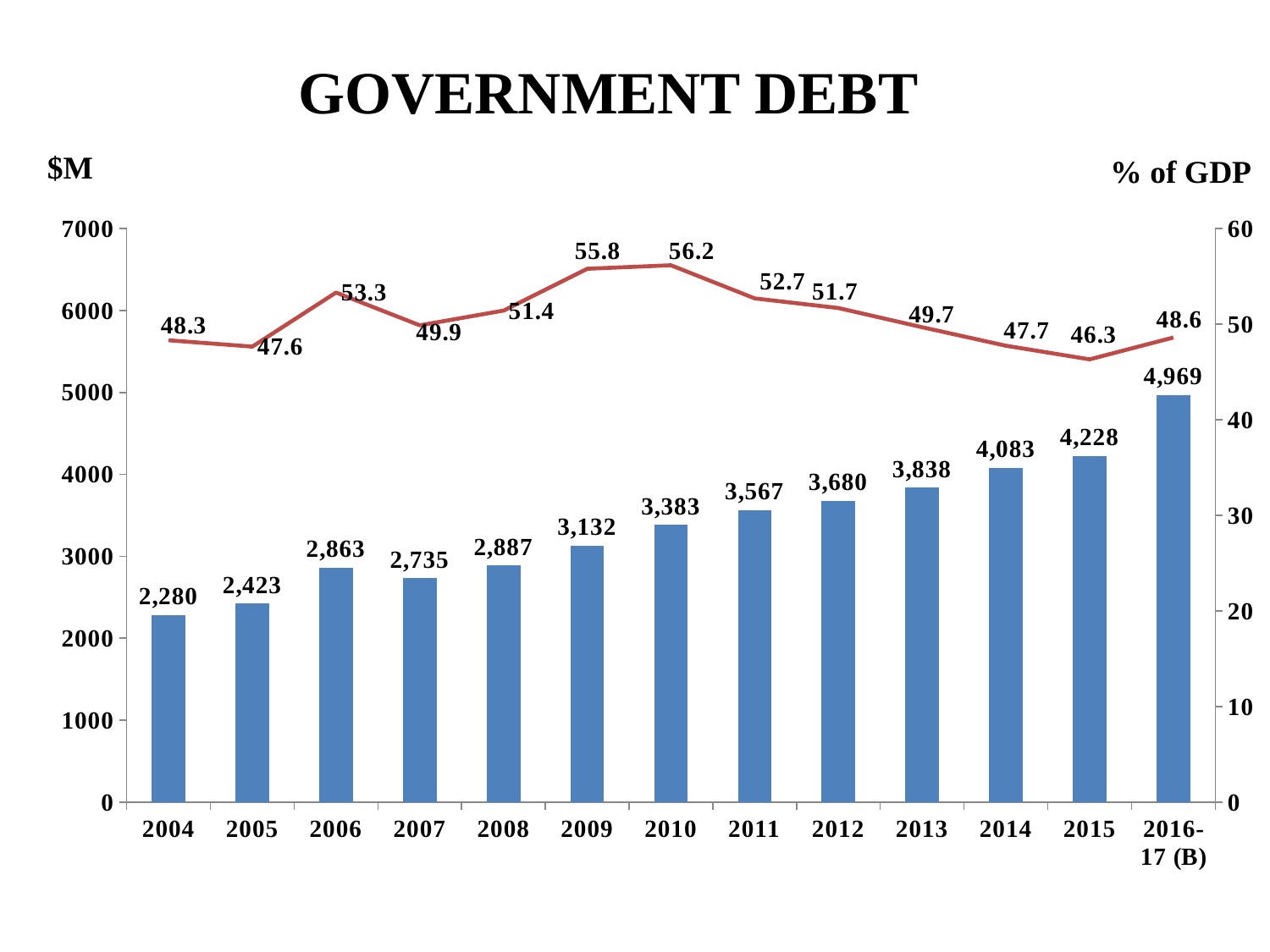
What is the difference in government debt ($M) between 2016-17 (B) and 2015? 741 In which year is debt as a % of GDP highest? 2010 Do the government debt bars generally rise or fall from 2004 to 2016-17 (B)? Rise Which year has the lowest government debt in $M? 2004 What is the government debt in $M for 2010? 3,383 What kind of chart is this? Combined bar and line chart Which year has the highest government debt in $M? 2016-17 (B) How many years are shown on the x axis? 13 What is the title of the chart? GOVERNMENT DEBT In which year is debt as a % of GDP lowest? 2015 What is the debt as a % of GDP in 2009? 55.8 Which year has the larger government debt in $M, 2006 or 2007? 2006